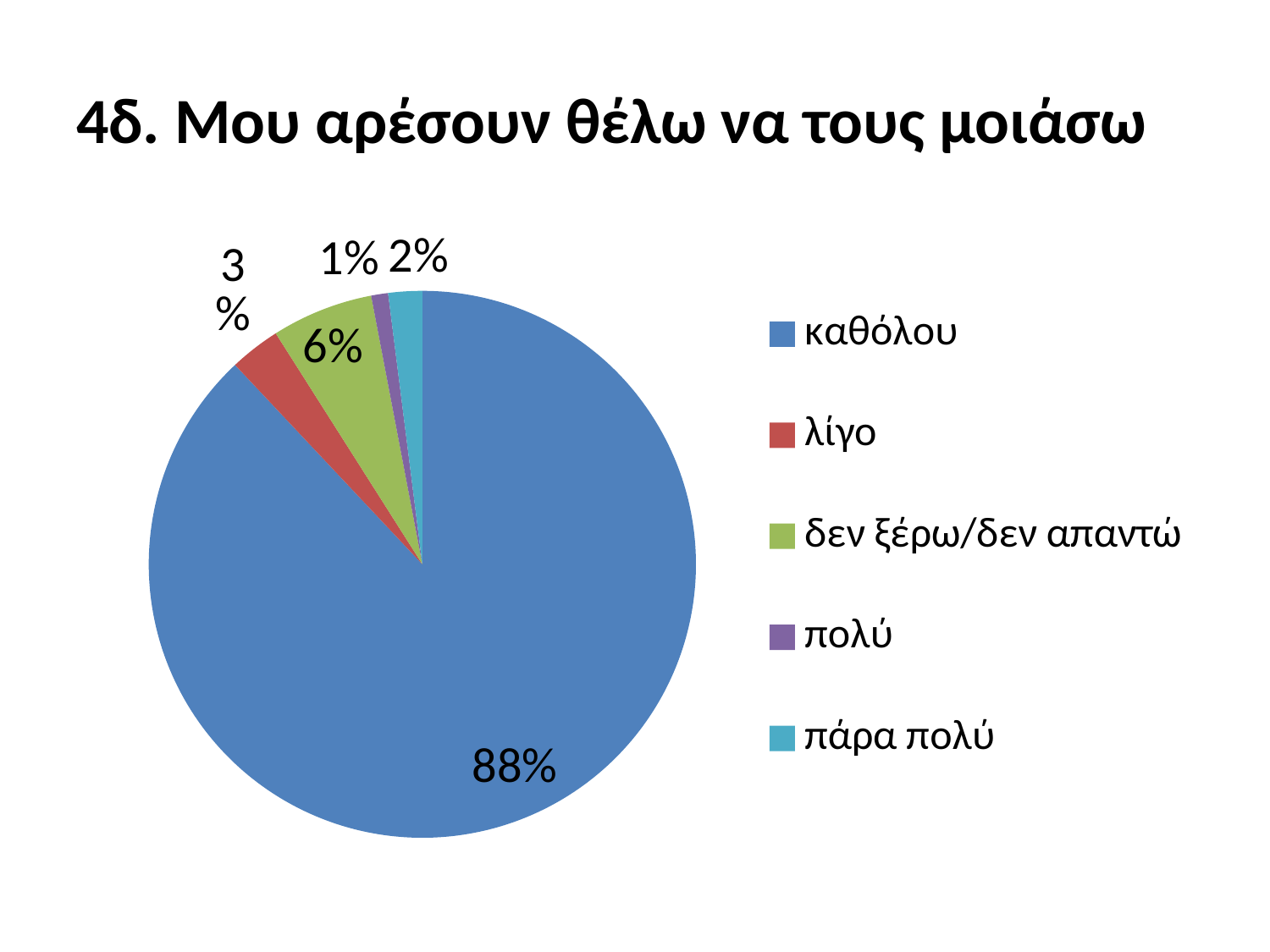
Which category has the largest slice of the pie? καθόλου What percentage is shown for 'πολύ'? 1% How many categories does the legend list? 5 Which is larger, the slice for 'λίγο' or the slice for 'δεν ξέρω/δεν απαντώ'? δεν ξέρω/δεν απαντώ What percentage is shown for 'δεν ξέρω/δεν απαντώ'? 6% What is the difference in percentage points between 'καθόλου' and 'δεν ξέρω/δεν απαντώ'? 82 What percentage is shown for 'πάρα πολύ'? 2% What percentage is shown for 'λίγο'? 3% What percentage of the pie does the 'καθόλου' slice represent? 88% What is the title of the chart? 4δ. Μου αρέσουν θέλω να τους μοιάσω Which category has the smallest slice of the pie? πολύ What kind of chart is shown on the slide? pie chart